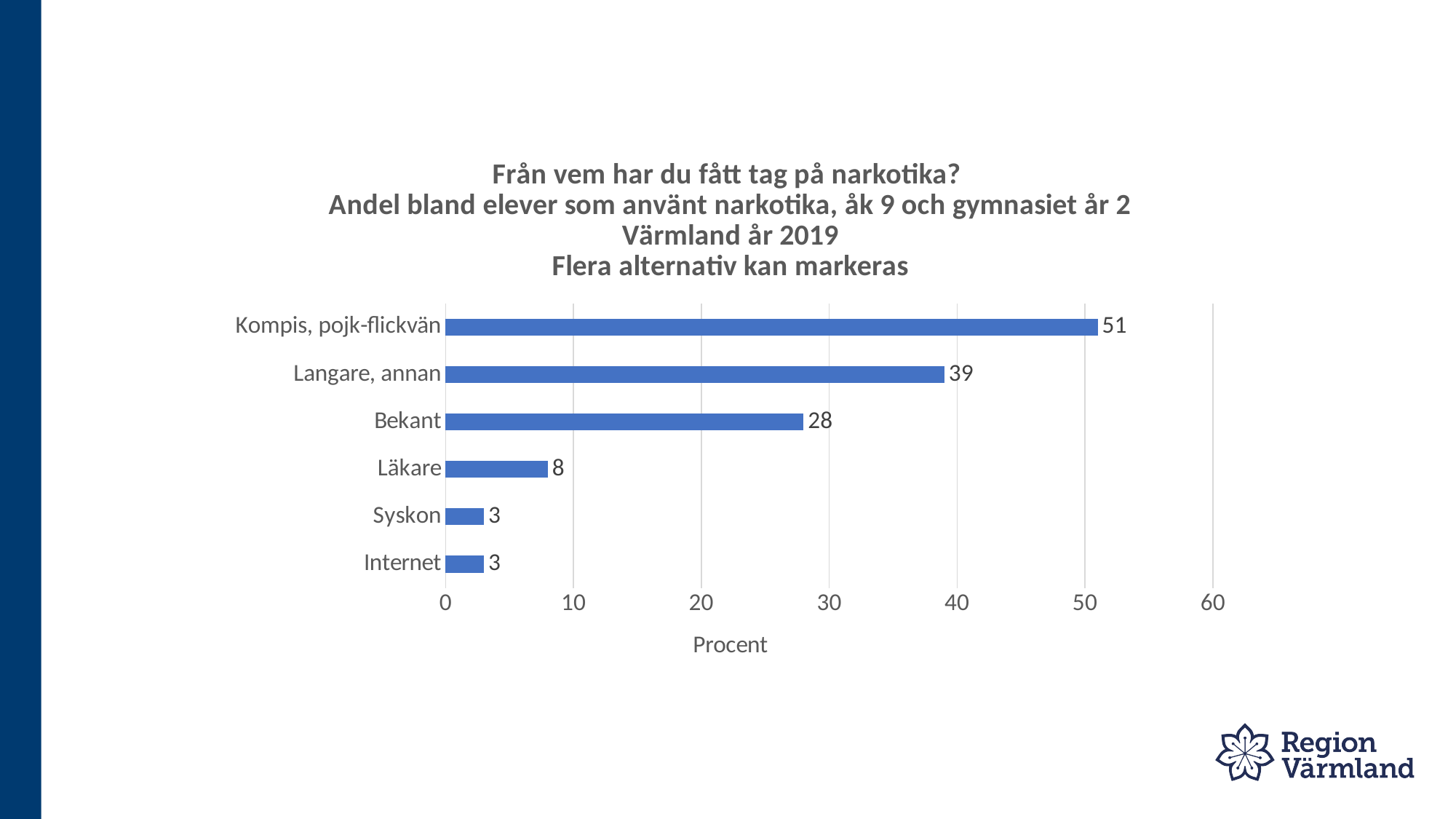
Is the value for Langare, annan greater or less than 30? greater What is the difference between the values for Bekant and Läkare? 20 What is the label of the horizontal axis? Procent What is the value for Bekant? 28 What is the difference between the values for Kompis, pojk-flickvän and Langare, annan? 12 What is the value for Syskon? 3 What kind of chart is shown on the slide? bar chart Which category has the highest value? Kompis, pojk-flickvän What is the value for Läkare? 8 How many categories are shown in the chart? 6 What is the value for Kompis, pojk-flickvän? 51 Which is larger, the value for Langare, annan or the value for Bekant? Langare, annan